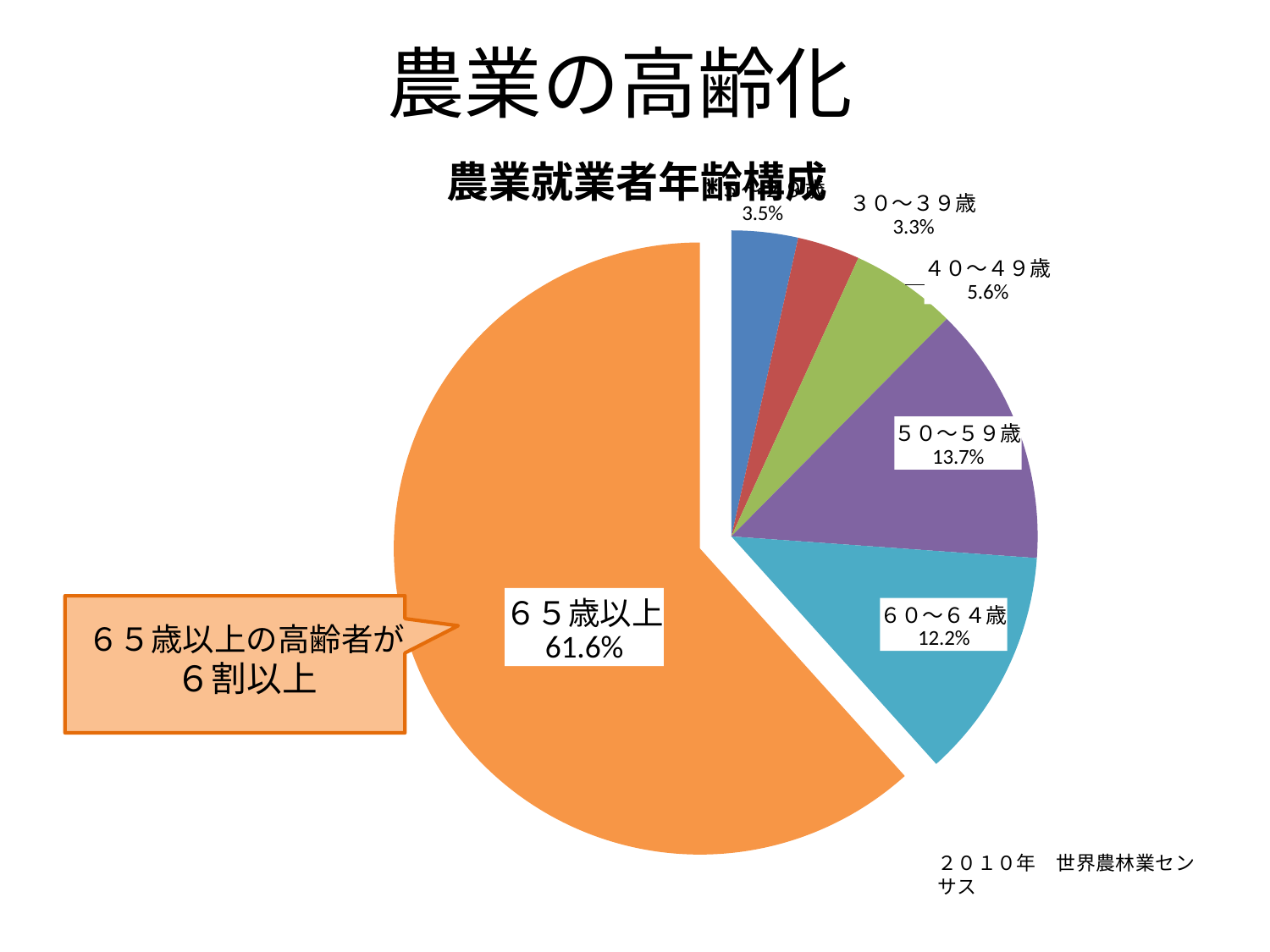
What is the value shown for ３０～３９歳? 3.3% What is the title of the chart? 農業就業者年齢構成 What is the value shown for ５０～５９歳? 13.7% Which is larger, the slice for ５０～５９歳 or the slice for ４０～４９歳? ５０～５９歳 What is the value shown for ４０～４９歳? 5.6% What kind of chart is shown on the slide? pie chart How many slices does the pie chart have? 6 What is the value shown for ６０～６４歳? 12.2% What is the difference between the values for ５０～５９歳 and ６０～６４歳? 1.5% What colour is the ６５歳以上 slice? orange Which age group has the largest slice of the pie? ６５歳以上 What share of the pie does the ６５歳以上 slice represent? 61.6%